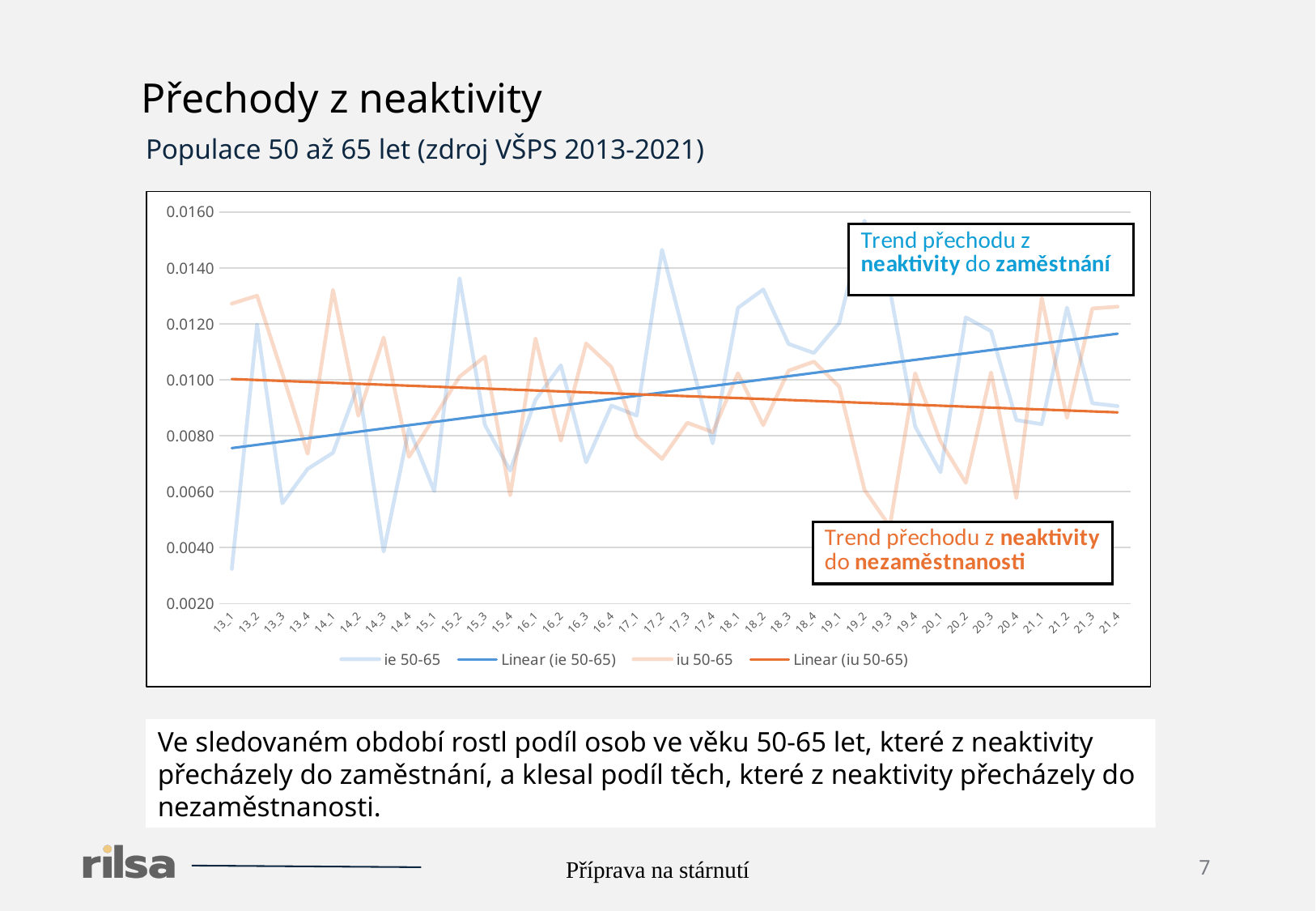
What is the first entry listed in the chart legend? ie 50-65 Does the Linear (iu 50-65) trend line rise or fall from 13_1 to 21_4? Falls How many quarterly points are shown along the x axis of the chart? 36 What kind of chart is shown on the slide? Line chart Is the value of iu 50-65 at 19_3 greater or less than 0.0060? less Does the Linear (ie 50-65) trend line rise or fall from 13_1 to 21_4? Rises Is the value of ie 50-65 at 17_2 greater or less than 0.0140? greater Is the value of ie 50-65 at 13_1 greater or less than 0.0040? less At 21_4, which trend line is higher: Linear (ie 50-65) or Linear (iu 50-65)? Linear (ie 50-65) How many series does the chart legend list? 4 At 13_1, which series has the larger value: ie 50-65 or iu 50-65? iu 50-65